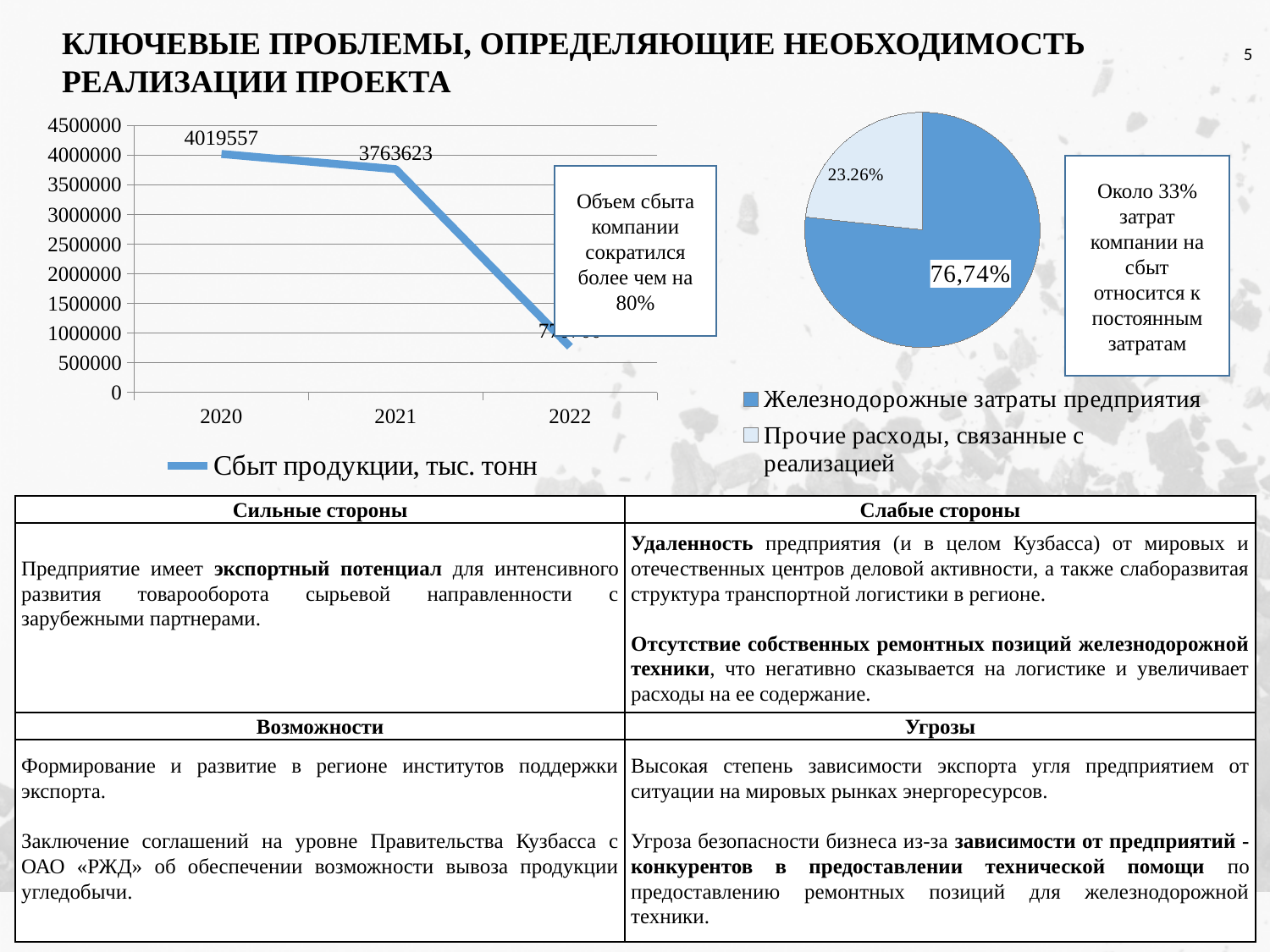
In the line chart on the left, what is the difference between the 2020 and 2021 values? 255934 What kind of chart is the chart on the left? line chart In the line chart on the left, do the values rise or fall from 2020 to 2022? fall In the line chart on the left, what is the value for 2020? 4019557 In the line chart on the left, what is the value for 2021? 3763623 In the line chart on the left, which year has the lowest value? 2022 In the pie chart on the right, what share is labelled for Прочие расходы, связанные с реализацией? 23.26% In the line chart on the left, is the value for 2022 greater or less than 1000000? less In the line chart on the left, how many years are plotted? 3 How many entries does the legend of the pie chart on the right list? 2 In the pie chart on the right, what share is labelled for Железнодорожные затраты предприятия? 76,74% In the line chart on the left, which year has the highest value? 2020